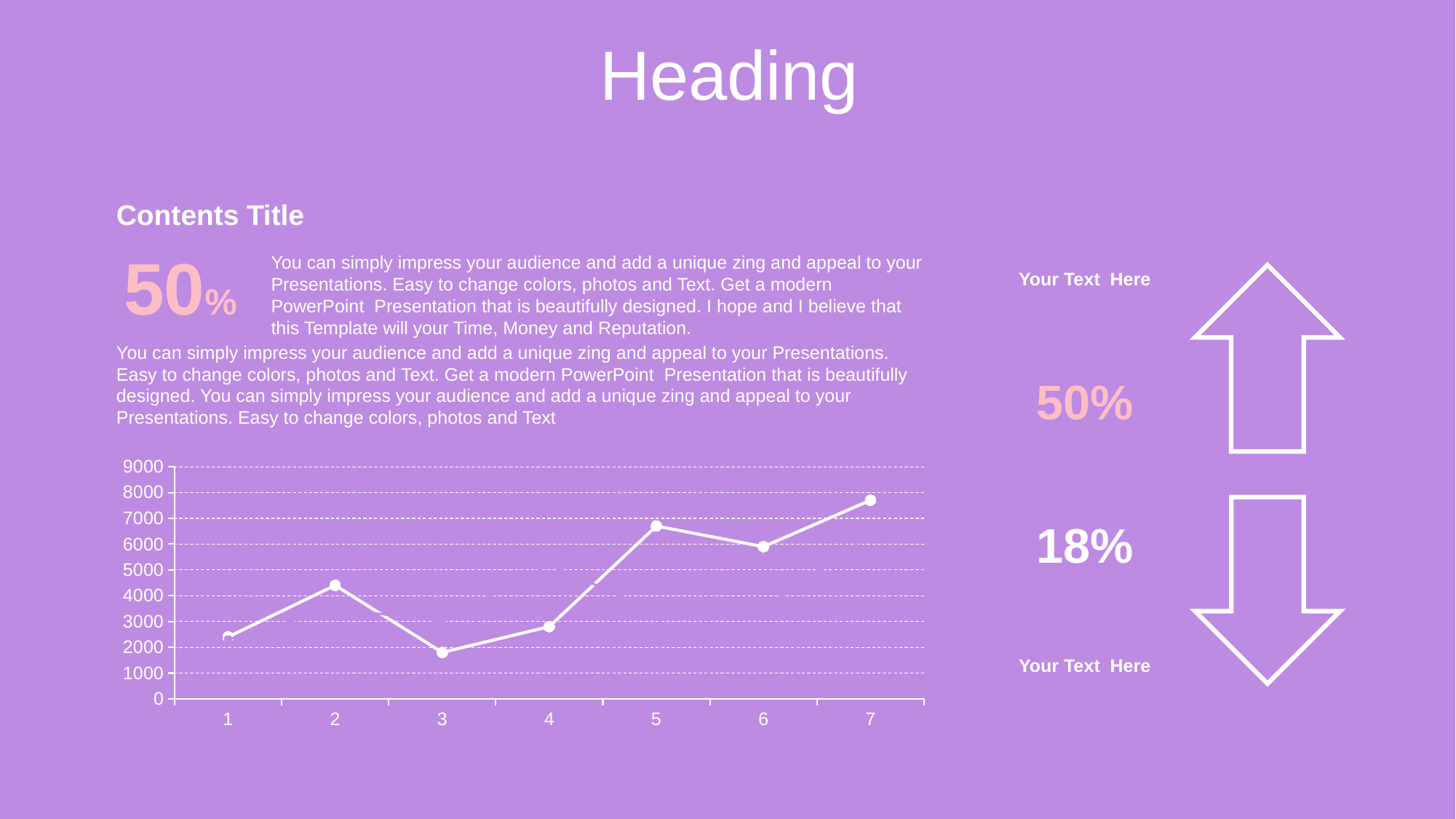
How many data points are plotted on the line chart? 7 Is the value for category 3 greater or less than 2000? less Which category on the x axis has the lowest value in the line chart? 3 What kind of chart is shown on the slide? line chart Which has the larger value, category 1 or category 4? 4 What is the highest value shown on the y axis of the line chart? 9000 Which has the larger value, category 5 or category 6? 5 Is the value for category 7 greater or less than 7000? greater Which category on the x axis has the highest value in the line chart? 7 Is the value for category 5 greater or less than 6000? greater Does the line rise or fall from category 2 to category 3? fall